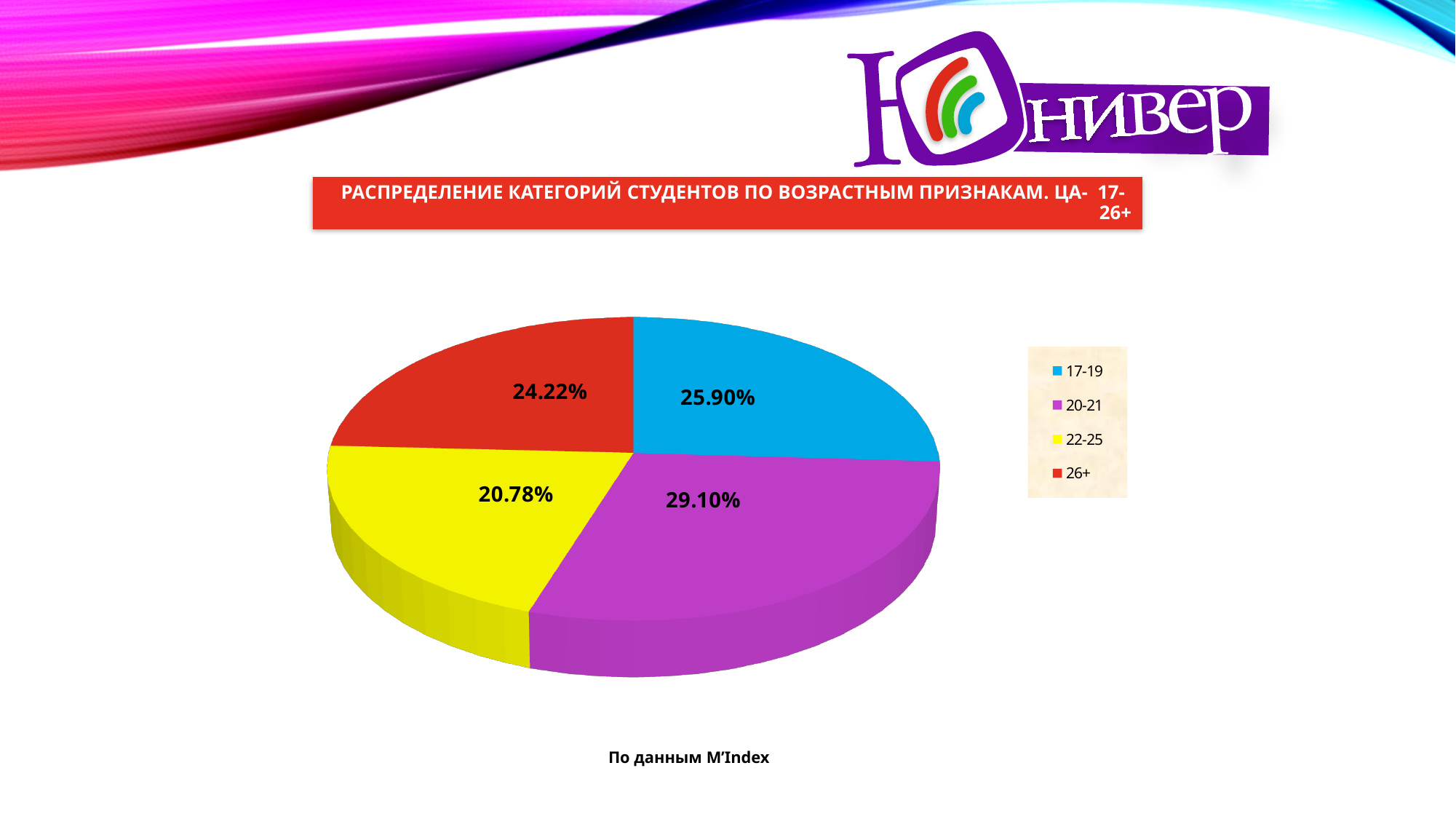
What share of students is in the 26+ age group? 24.22% Which age group has the smallest share of the pie? 22-25 What share of students is in the 20-21 age group? 29.10% Which age group has the largest share of the pie? 20-21 Which has a larger share, the 17-19 group or the 26+ group? 17-19 What data source is cited below the chart? M'Index What is the difference between the shares of the 20-21 and 22-25 age groups? 8.32% What share of students is in the 22-25 age group? 20.78% How many age groups does the legend list? 4 What colour represents the 22-25 age group in the pie chart? yellow What kind of chart is shown on the slide? pie chart What share of students is in the 17-19 age group? 25.90%